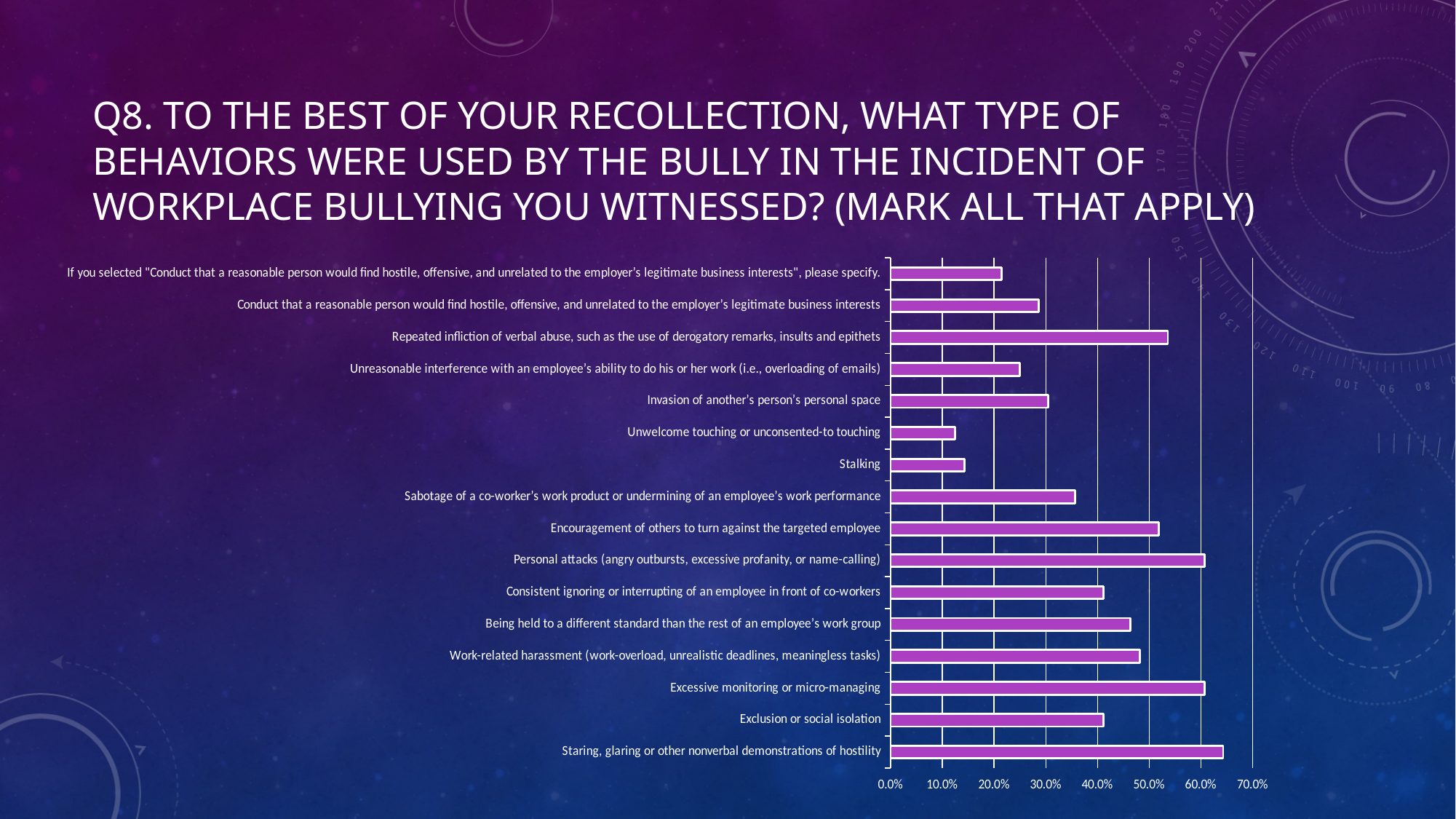
Which has a larger value: "Repeated infliction of verbal abuse, such as the use of derogatory remarks, insults and epithets" or "Sabotage of a co-worker's work product or undermining of an employee's work performance"? Repeated infliction of verbal abuse, such as the use of derogatory remarks, insults and epithets Is the value for "Repeated infliction of verbal abuse, such as the use of derogatory remarks, insults and epithets" greater or less than 50.0%? greater What kind of chart is shown on the slide? bar chart What is the highest value shown on the chart's horizontal axis? 70.0% How many behavior categories are plotted in the chart? 16 Which behavior category has the highest value in the chart? Staring, glaring or other nonverbal demonstrations of hostility What colour are the bars in the chart? purple Which has a larger value: "Stalking" or "Invasion of another's person's personal space"? Invasion of another's person's personal space Is the value for "Stalking" greater or less than 20.0%? less Is the value for "Work-related harassment (work-overload, unrealistic deadlines, meaningless tasks)" greater or less than 50.0%? less